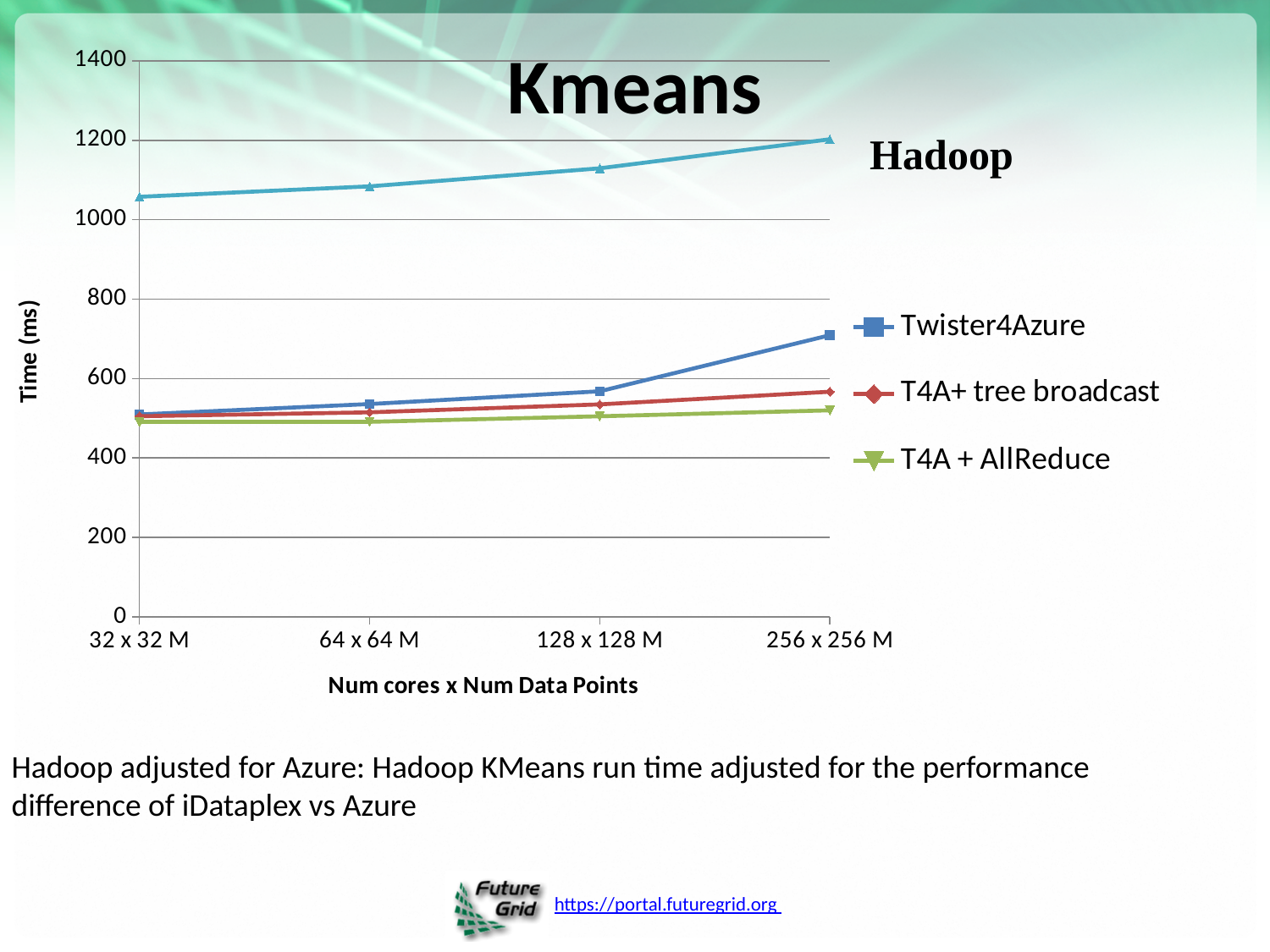
Is the Hadoop time at 32 x 32 M greater or less than 1000? greater What is the title of the chart on the slide? Kmeans Does the Hadoop time rise or fall as the x axis goes from 32 x 32 M to 256 x 256 M? rise Is the Twister4Azure time at 256 x 256 M greater or less than 600? greater Is the Twister4Azure time at 256 x 256 M greater or less than 800? less What kind of chart is shown on the slide? line chart Which is larger at 256 x 256 M: the Twister4Azure time or the T4A + AllReduce time? Twister4Azure How many categories are shown on the x axis of the Kmeans chart? 4 How many series does the legend of the Kmeans chart list? 3 Which series has the highest time at 256 x 256 M in the Kmeans chart? Hadoop Which series has the lowest time at 256 x 256 M in the Kmeans chart? T4A + AllReduce